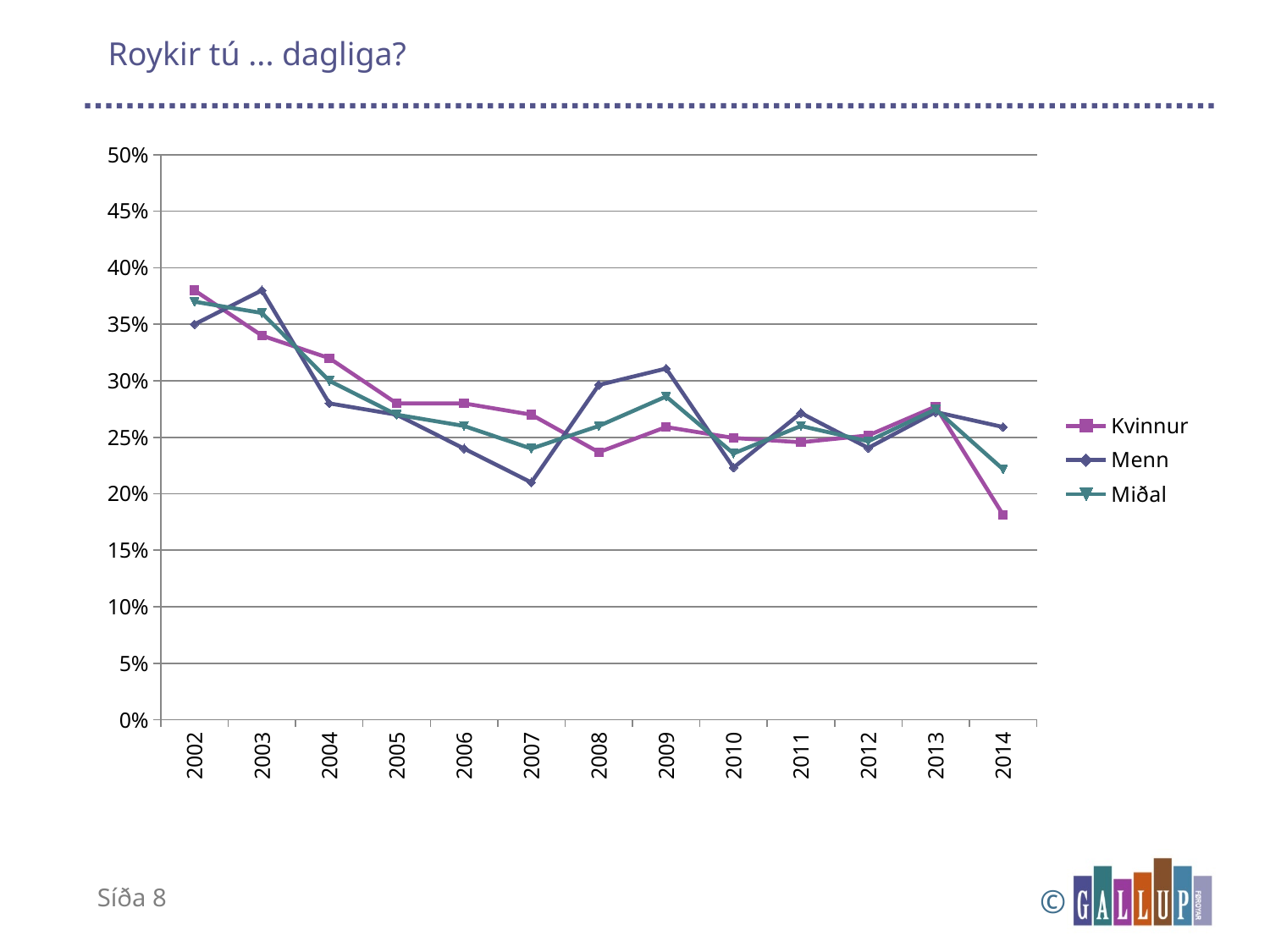
Is the value for Menn in 2007 greater or less than 25%? less What kind of chart is shown on the slide? line chart In which year is the Kvinnur series at its lowest? 2014 In which year is the Menn series at its highest? 2003 Is the value for Menn in 2003 greater or less than 35%? greater In 2009, which is larger, the value for Menn or the value for Kvinnur? Menn Which series does the legend list first? Kvinnur Is the value for Kvinnur in 2014 greater or less than 20%? less How many series does the legend list? 3 How many years are plotted along the x axis? 13 What is the title of the slide? Roykir tú ... dagliga?